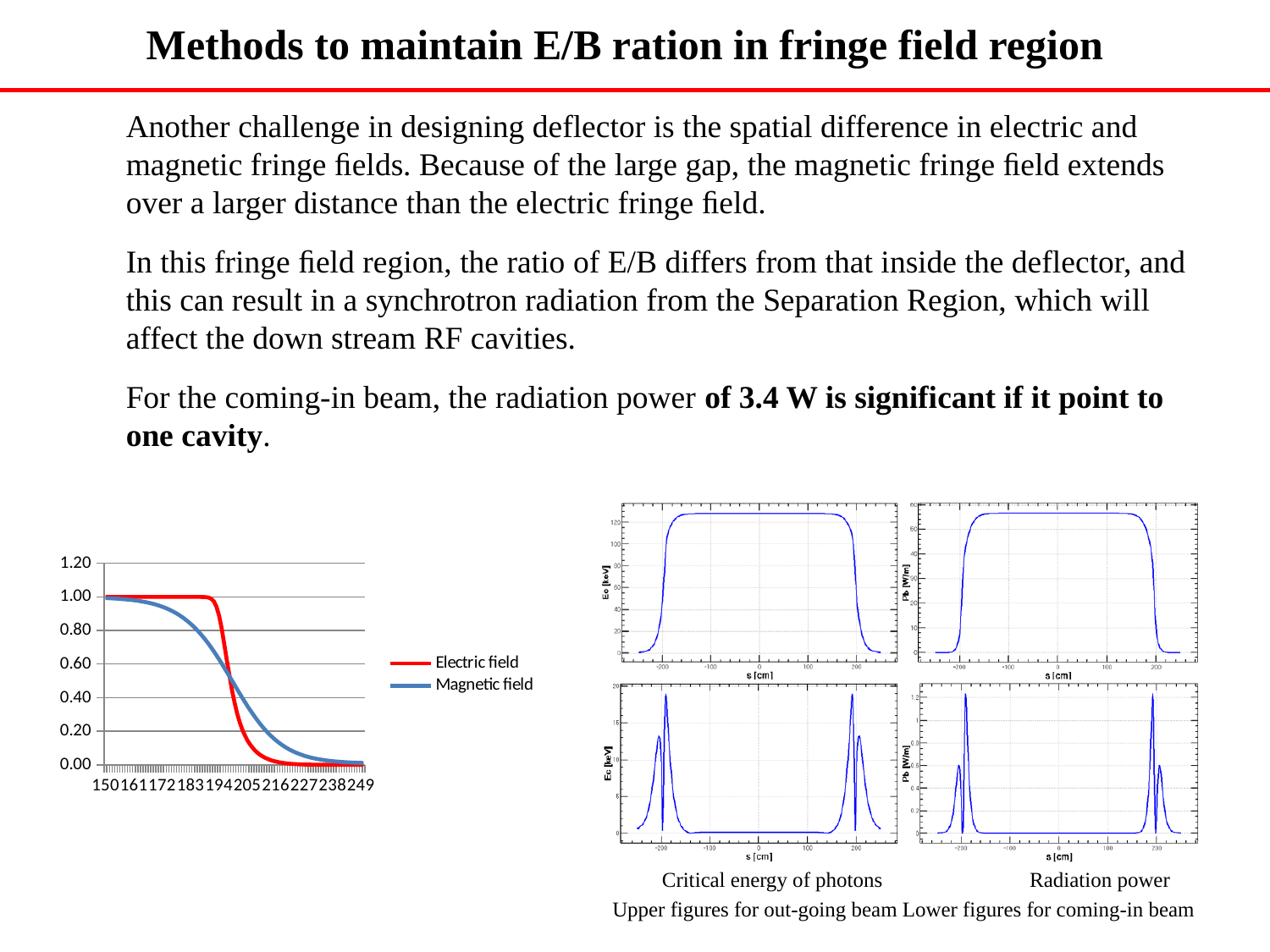
In the left chart, which series drops more steeply, Electric field or Magnetic field? Electric field In the left chart, is the Magnetic field value at x = 249 greater or less than 0.20? less What is the x-axis label shown on the four small plots on the right of the slide? s [cm] In the left chart, what colour is the Electric field line? red In the left chart, do the Electric field and Magnetic field values rise or fall as you move along the x axis from 150 to 249? fall What are the two series named in the legend of the left chart? Electric field, Magnetic field In the left chart, at x = 216, which series has the larger value, Electric field or Magnetic field? Magnetic field How many series does the legend of the left chart list? 2 In the left chart, at x = 172, which series has the larger value, Electric field or Magnetic field? Electric field In the left chart, is the Electric field value at x = 150 greater or less than 0.80? greater What kind of chart is the chart on the left of the slide with the Electric field and Magnetic field legend? line chart